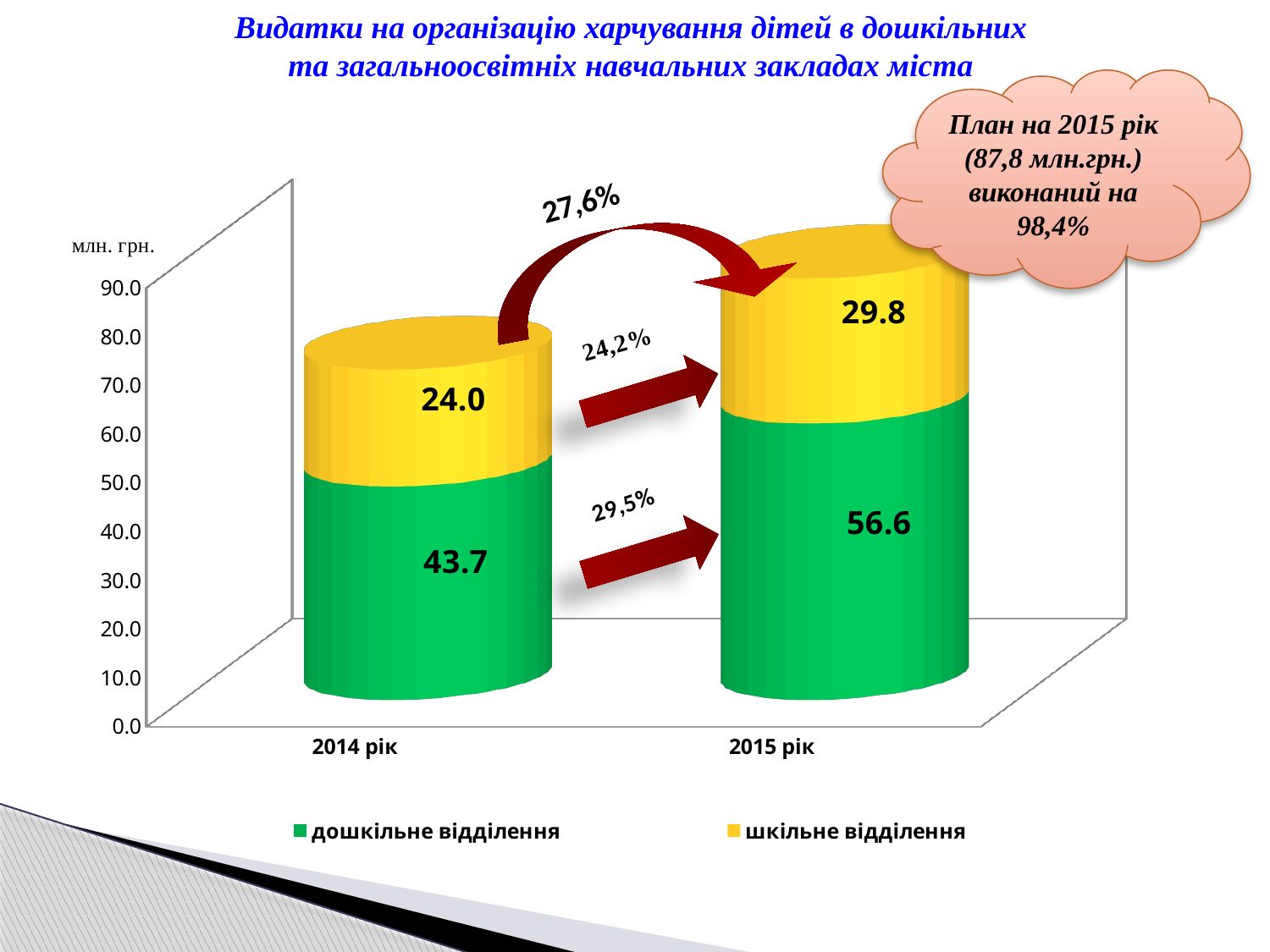
What is the total of the stacked bar for 2015 рік? 86.4 What is the value for дошкільне відділення in 2014 рік? 43.7 What is the value for шкільне відділення in 2015 рік? 29.8 What is the value for дошкільне відділення in 2015 рік? 56.6 How many categories are shown on the x axis? 2 Which is larger: шкільне відділення in 2014 рік or шкільне відділення in 2015 рік? 2015 рік What kind of chart is shown on the slide? stacked bar chart What is the value for шкільне відділення in 2014 рік? 24.0 How many series does the legend list? 2 In which year is the дошкільне відділення value highest? 2015 рік What is the difference between the дошкільне відділення values for 2015 рік and 2014 рік? 12.9 What is the total of the stacked bar for 2014 рік? 67.7